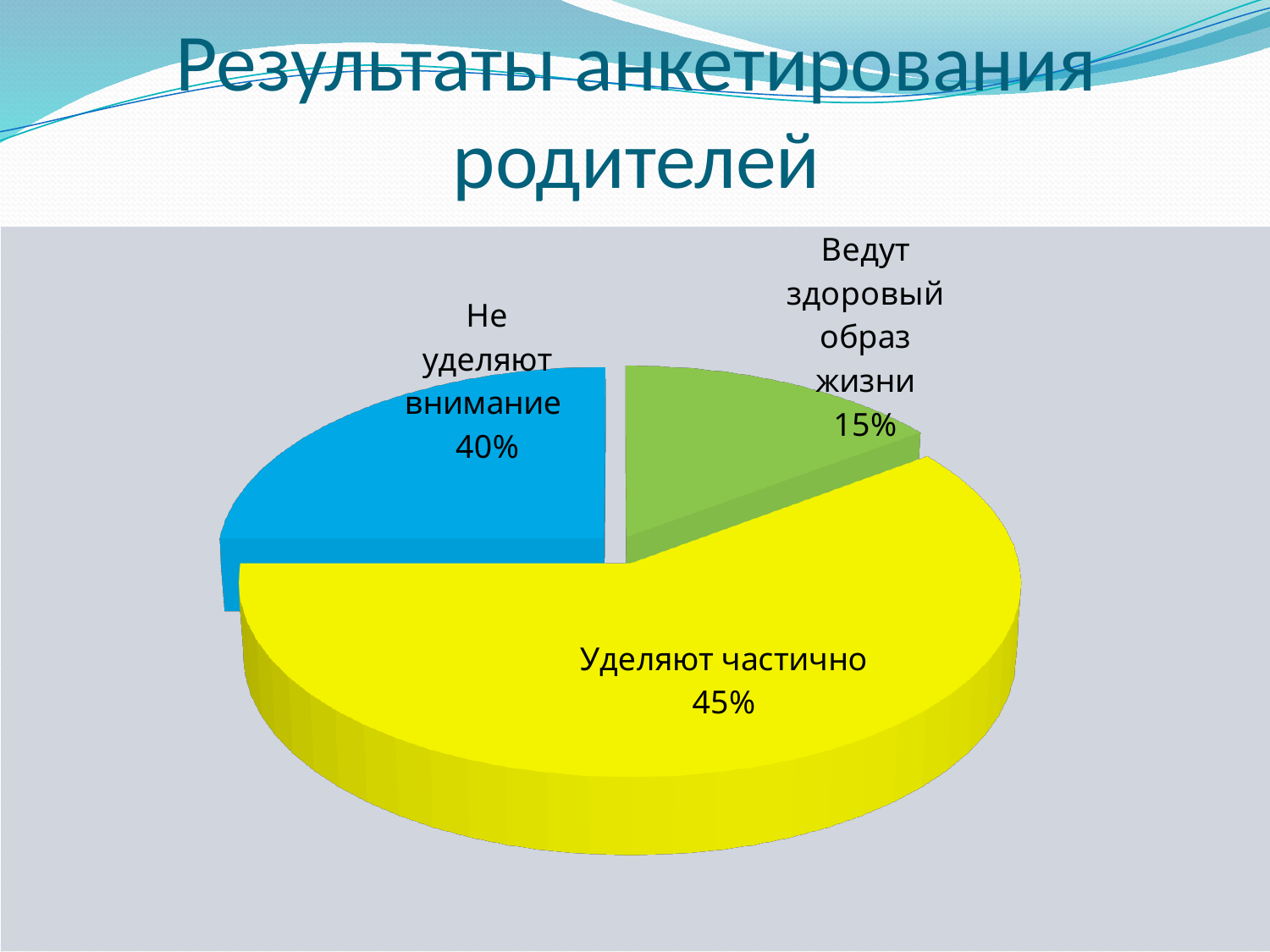
What share of the pie is labelled "Ведут здоровый образ жизни"? 15% What is the difference in percentage points between "Уделяют частично" and "Ведут здоровый образ жизни"? 30% What colour is the slice for "Уделяют частично"? yellow What kind of chart is shown on the slide? pie chart What share of the pie is labelled "Уделяют частично"? 45% Which is larger: the slice for "Не уделяют внимание" or the slice for "Ведут здоровый образ жизни"? Не уделяют внимание Which category has the smallest slice of the pie? Ведут здоровый образ жизни What is the difference in percentage points between "Уделяют частично" and "Не уделяют внимание"? 5% How many slices does the pie chart have? 3 What is the title of the slide containing the chart? Результаты анкетирования родителей What share of the pie is labelled "Не уделяют внимание"? 40% Which category has the largest slice of the pie? Уделяют частично